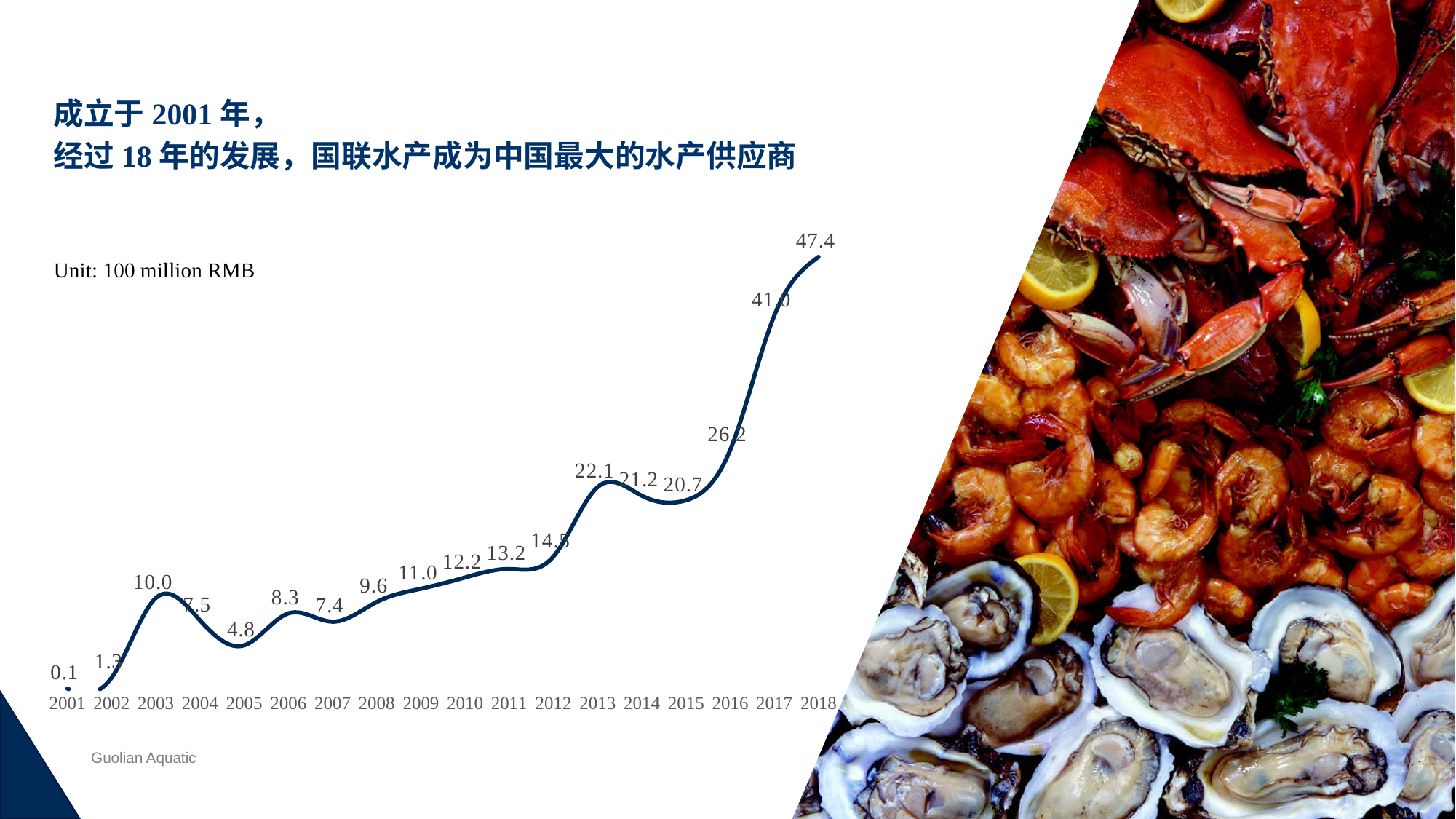
What type of chart is shown on the slide? line chart What is the value for 2003? 10.0 What is the value for 2018? 47.4 Which is larger, the value for 2004 or the value for 2005? 2004 What is the difference between the values for 2018 and 2017? 6.4 What unit is stated for the values in the chart? 100 million RMB What is the value for 2010? 12.2 What is the difference between the values for 2013 and 2012? 7.6 What is the value for 2013? 22.1 How many years are plotted on the x axis? 18 Which year has the highest value? 2018 Which year has the lowest value? 2001